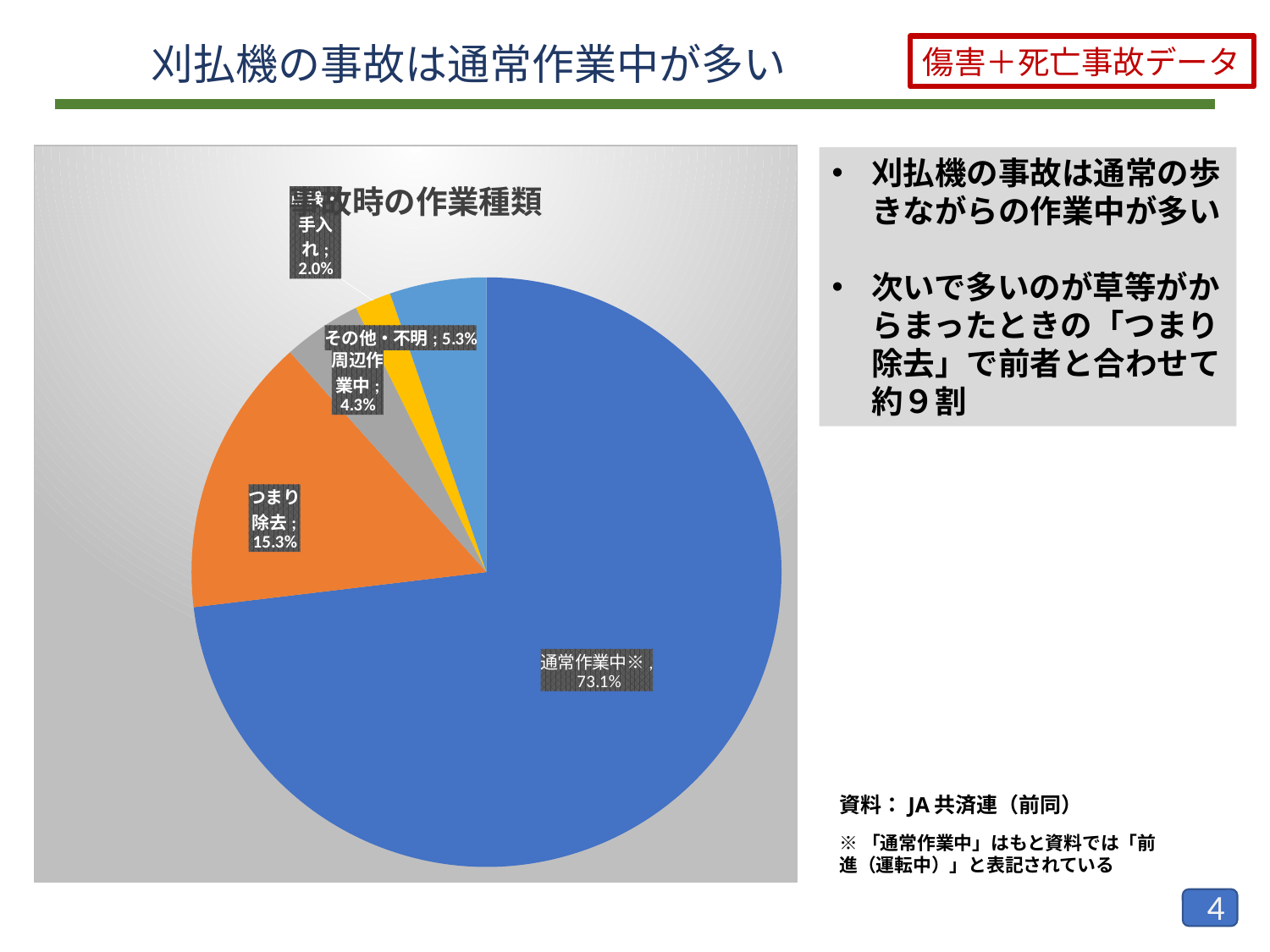
How many slices does the pie chart have? 5 Which is larger, the share for その他・不明 or the share for 周辺作業中? その他・不明 What type of chart is shown on the slide? Pie chart What colour is the つまり除去 slice? Orange What is the value shown for その他・不明? 5.3% Which category has the smallest share of the pie chart? 手入れ What percentage of the pie chart is the 通常作業中※ slice? 73.1% What is the difference in percentage points between 通常作業中※ and つまり除去? 57.8 What is the combined share of 通常作業中※ and つまり除去? 88.4% Which category has the largest share of the pie chart? 通常作業中※ What percentage does the つまり除去 slice represent? 15.3% What is the value shown for 周辺作業中? 4.3%